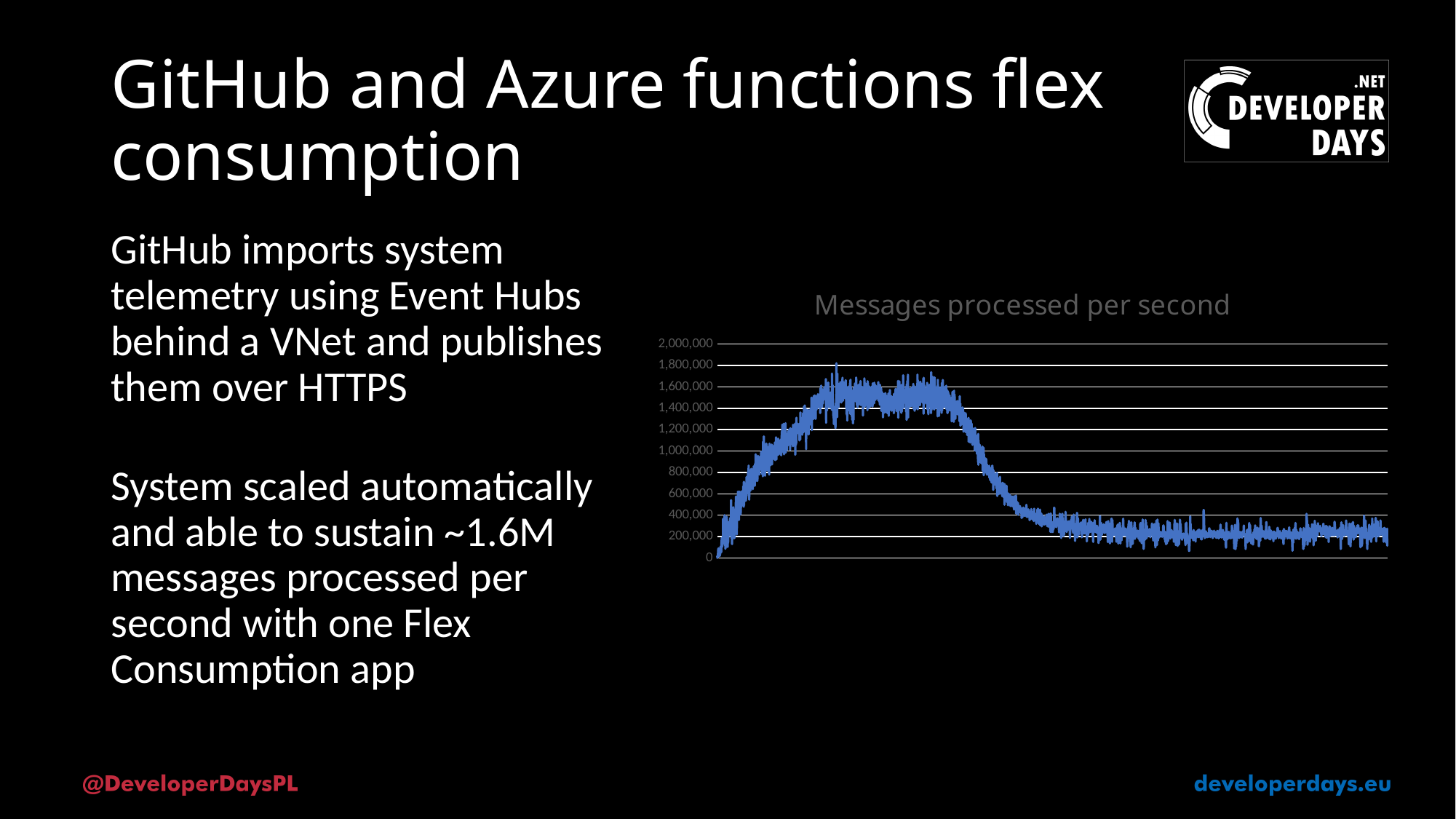
What is the title of the chart? Messages processed per second Is the peak value of the line greater or less than 2,000,000? less What is the highest value labelled on the chart's vertical axis? 2,000,000 After reaching its peak, does the line rise or fall toward the right side of the chart? fall What is the interval between consecutive tick labels on the vertical axis? 200,000 Is the peak value of the line greater or less than 1,400,000? greater What kind of chart is shown on the slide? line chart Is the value of the line at the right end of the chart greater or less than 600,000? less Is the value of the line at the right end of the chart greater or less than its peak value? less Does the line rise or fall over the first part of the chart, from the left edge to its peak? rise